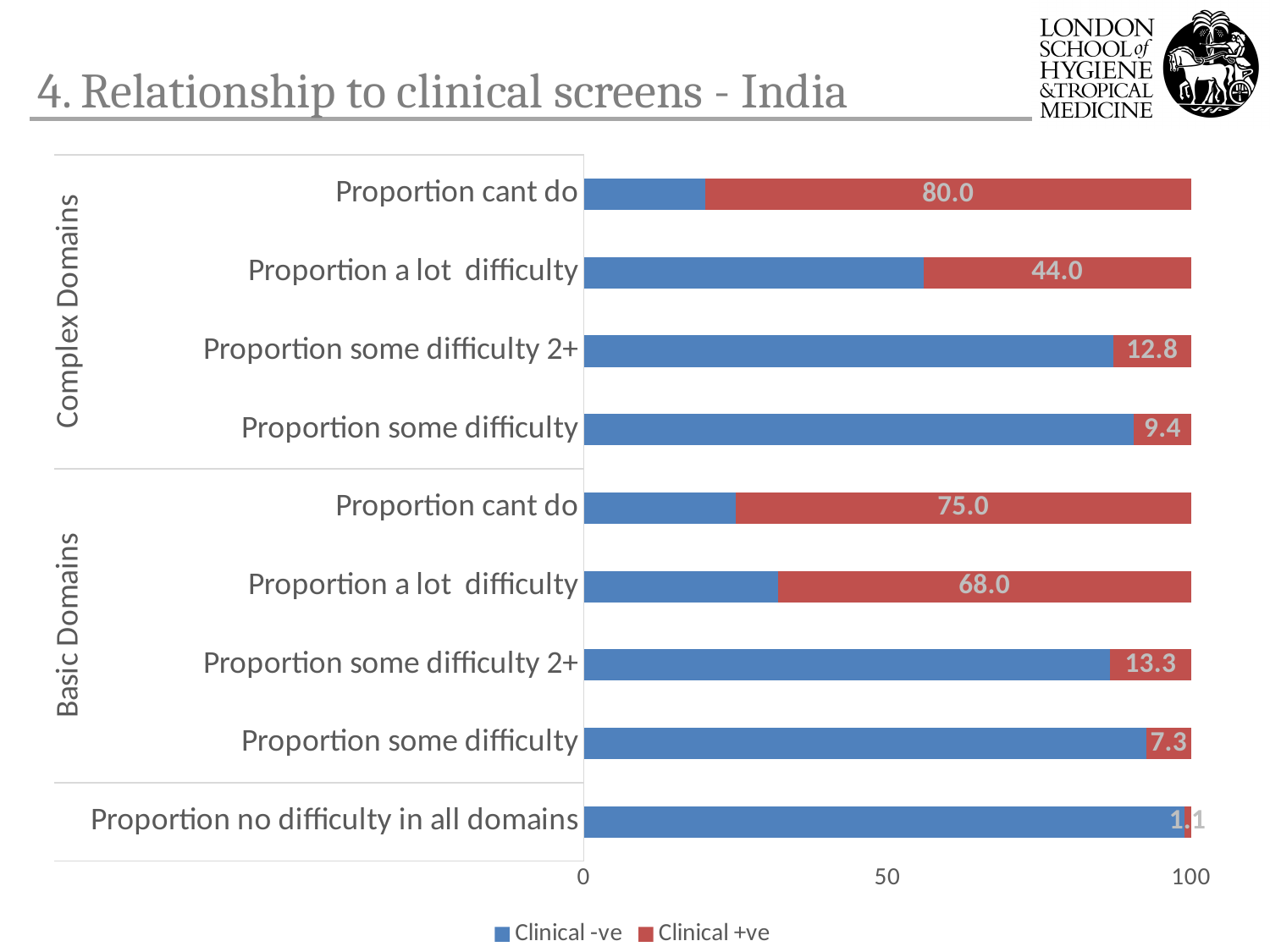
How many bars are plotted in the chart? 9 What is the Clinical +ve value for 'Proportion a lot difficulty' in the Basic Domains group? 68.0 How many series does the legend list? 2 What is the difference between the Clinical +ve values for 'Proportion cant do' in Complex Domains and in Basic Domains? 5.0 What is the Clinical +ve value for 'Proportion cant do' in the Complex Domains group? 80.0 Which category has the lowest Clinical +ve value? Proportion no difficulty in all domains Is the Clinical -ve value for 'Proportion a lot difficulty' in Complex Domains greater or less than 50? greater Which has the larger Clinical +ve value: 'Proportion some difficulty 2+' in Complex Domains or in Basic Domains? Basic Domains What kind of chart is shown on the slide? Stacked bar chart What is the Clinical +ve value for 'Proportion no difficulty in all domains'? 1.1 What are the two legend entries of the chart? Clinical -ve and Clinical +ve Which category has the highest Clinical +ve value? Proportion cant do (Complex Domains)